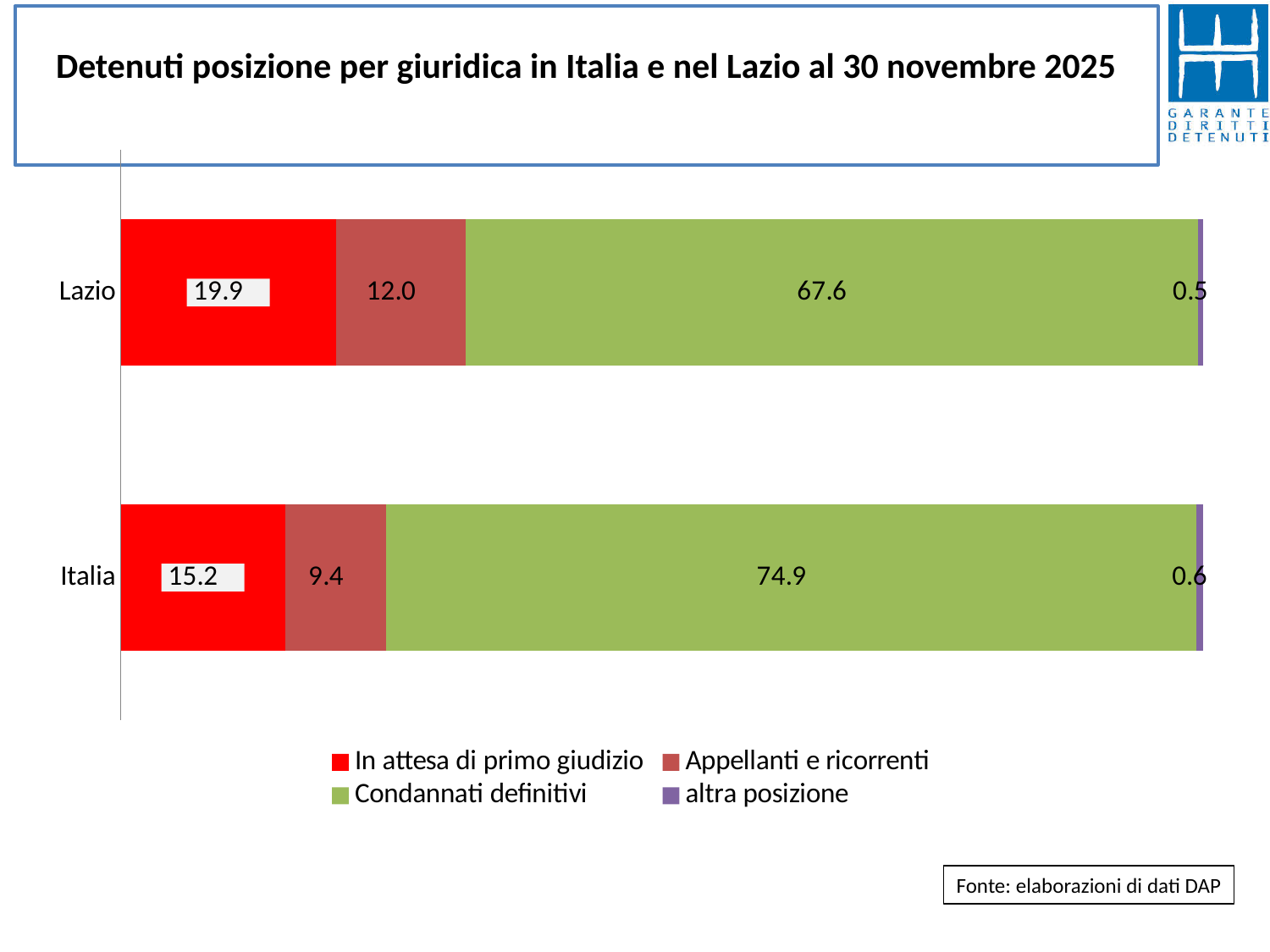
What is the value for 'Condannati definitivi' for Italia? 74.9 Which series has the largest value in the Italia bar? Condannati definitivi What is the difference between the 'In attesa di primo giudizio' values for Lazio and Italia? 4.7 What is the value for 'Appellanti e ricorrenti' for Lazio? 12.0 What kind of chart is shown on the slide? Stacked bar chart Which series has the smallest value in the Lazio bar? altra posizione What is the difference between the 'Condannati definitivi' values for Italia and Lazio? 7.3 Which has the larger 'Appellanti e ricorrenti' value, Lazio or Italia? Lazio How many categories (bars) are shown in the chart? 2 What is the value for 'In attesa di primo giudizio' for Lazio? 19.9 How many series does the legend list? 4 What is the value for 'altra posizione' for Italia? 0.6